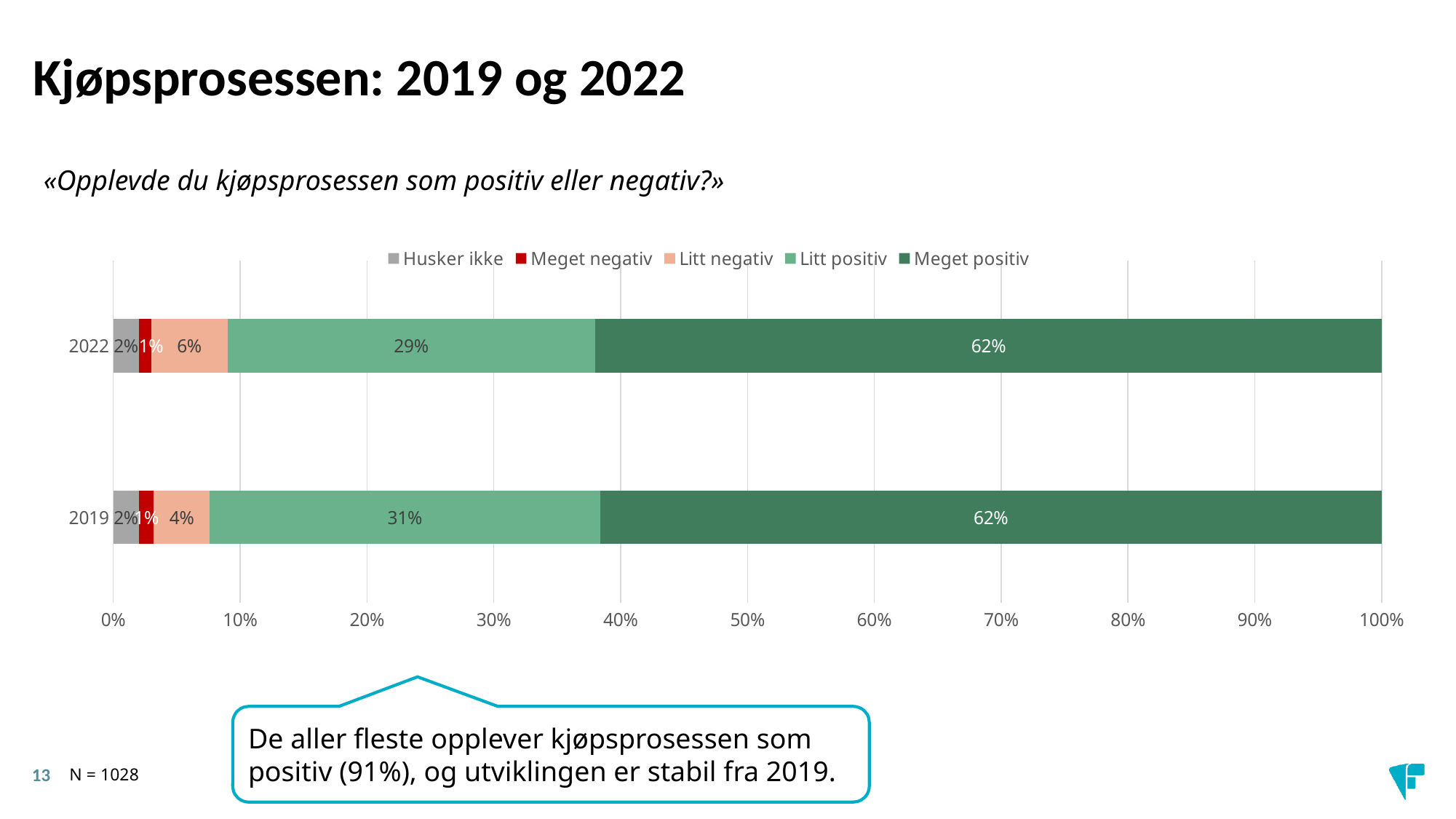
What is the value for Meget positiv in 2022? 62% What is the total of the stacked bar for 2022? 100% What is the value for Litt positiv in 2019? 31% How many categories (years) are shown on the chart? 2 Which series has the highest value in 2022? Meget positiv What kind of chart is shown on the slide? Stacked bar chart What is the value for Husker ikke in 2019? 2% Which series has the lowest value in 2019? Meget negativ What is the difference between the Litt positiv values for 2019 and 2022? 2% What is the value for Litt negativ in 2022? 6% How many series does the legend list? 5 Which year has the larger value for Litt negativ, 2019 or 2022? 2022